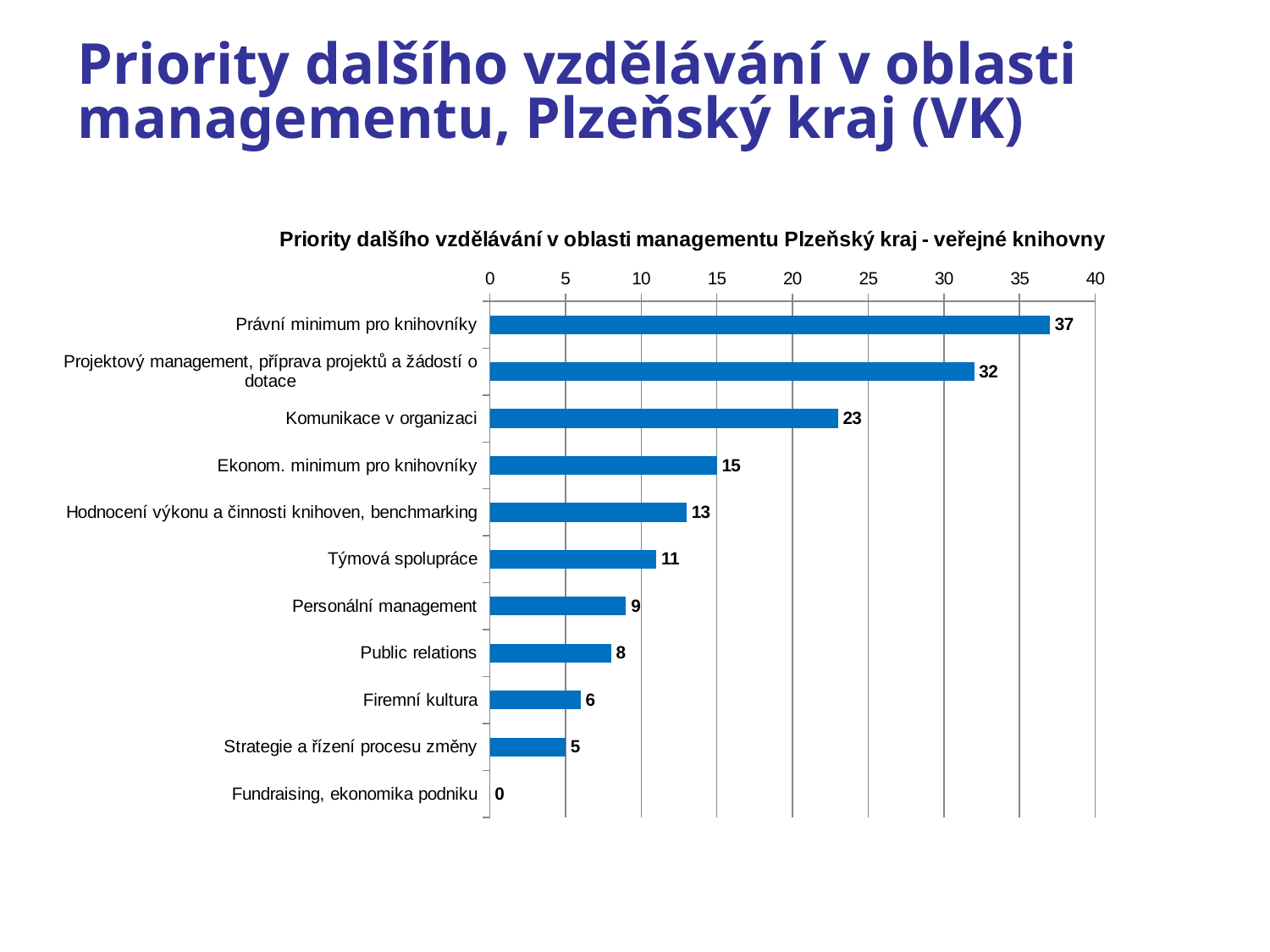
Which is larger, the value for Personální management or the value for Public relations? Personální management What kind of chart is shown on the slide? Bar chart What is the title of the chart? Priority dalšího vzdělávání v oblasti managementu Plzeňský kraj - veřejné knihovny What is the value for Strategie a řízení procesu změny? 5 What is the value for Právní minimum pro knihovníky? 37 Which category has the highest value? Právní minimum pro knihovníky How many categories are shown in the chart? 11 What is the value for Týmová spolupráce? 11 Is the value for Ekonom. minimum pro knihovníky greater or less than 10? greater Which category has the lowest value? Fundraising, ekonomika podniku What is the difference between the values for Právní minimum pro knihovníky and Projektový management, příprava projektů a žádostí o dotace? 5 What is the value for Komunikace v organizaci? 23